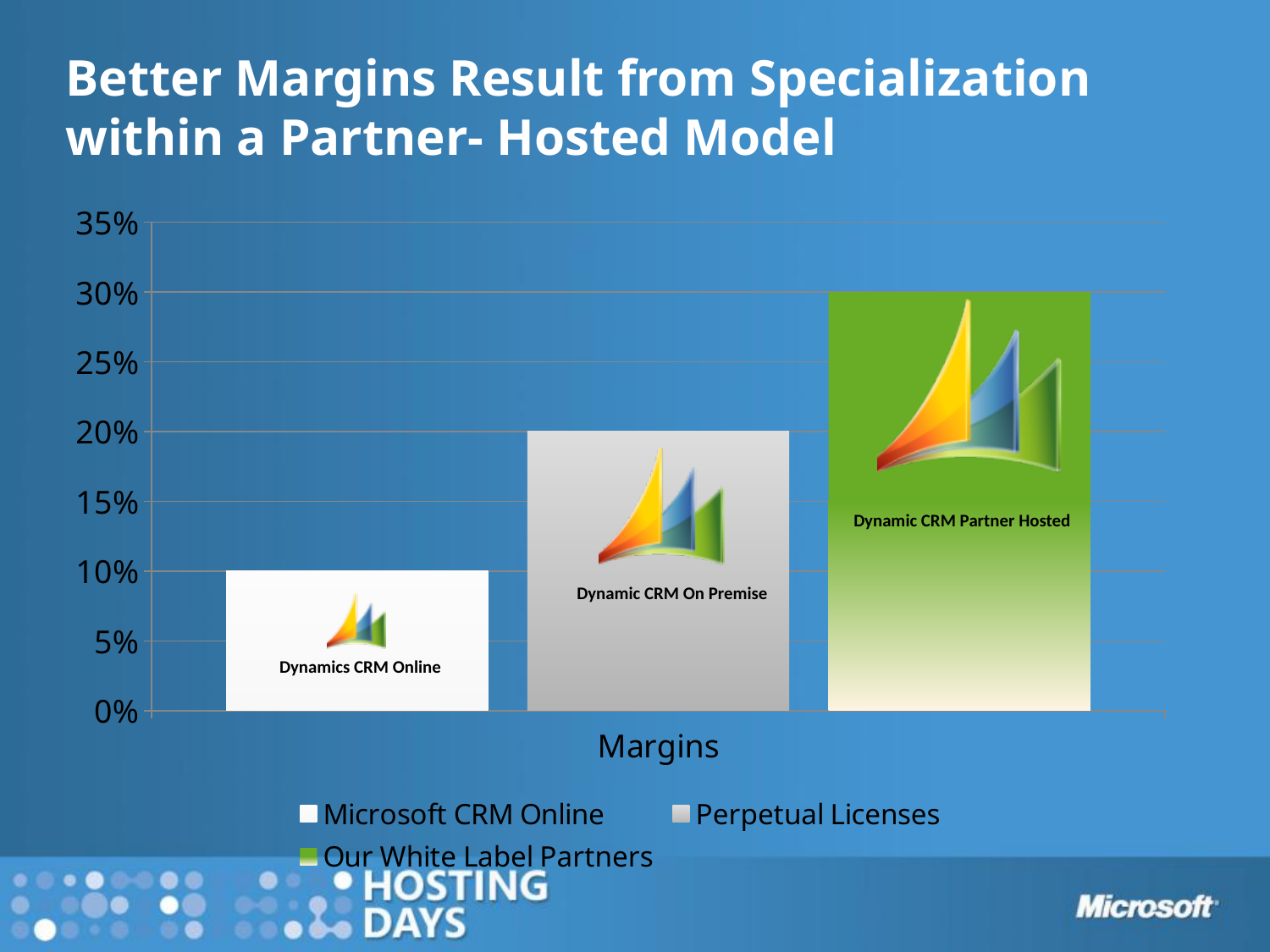
What kind of chart is shown on the slide? bar chart What is the label on the x axis of the chart? Margins Is the margin for Perpetual Licenses greater or less than 15%? greater Which is larger, the margin for Perpetual Licenses or the margin for Microsoft CRM Online? Perpetual Licenses What is the margin value for Perpetual Licenses? 20% What is the margin value for Microsoft CRM Online? 10% What is the margin value for Our White Label Partners? 30% How many series does the legend list? 3 Which series has the lowest margin? Microsoft CRM Online Which series has the highest margin? Our White Label Partners What is the difference between the margin for Our White Label Partners and the margin for Microsoft CRM Online? 20% What is the title of the slide? Better Margins Result from Specialization within a Partner- Hosted Model